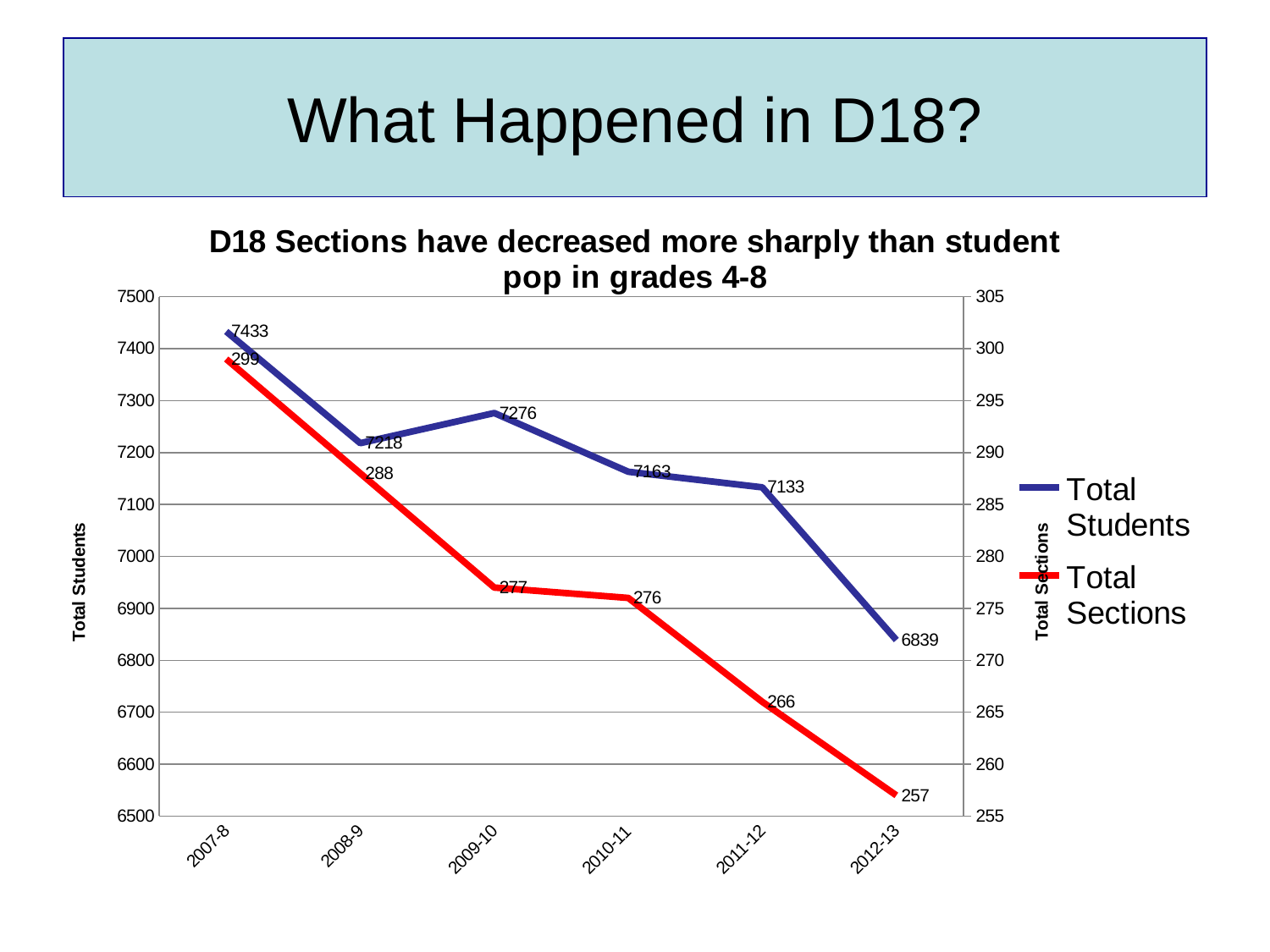
What is the value of Total Sections in 2012-13? 257 What is the value of Total Students in 2011-12? 7133 How many series does the legend list? 2 What is the value of Total Students in 2007-8? 7433 In which year is Total Students lowest? 2012-13 What kind of chart is shown? line chart Which is larger, Total Students in 2008-9 or in 2009-10? 2009-10 What is the difference between Total Students in 2007-8 and 2012-13? 594 What is the value of Total Sections in 2009-10? 277 In which year is Total Sections highest? 2007-8 What is the difference between Total Sections in 2008-9 and 2009-10? 11 How many years are shown on the x axis? 6